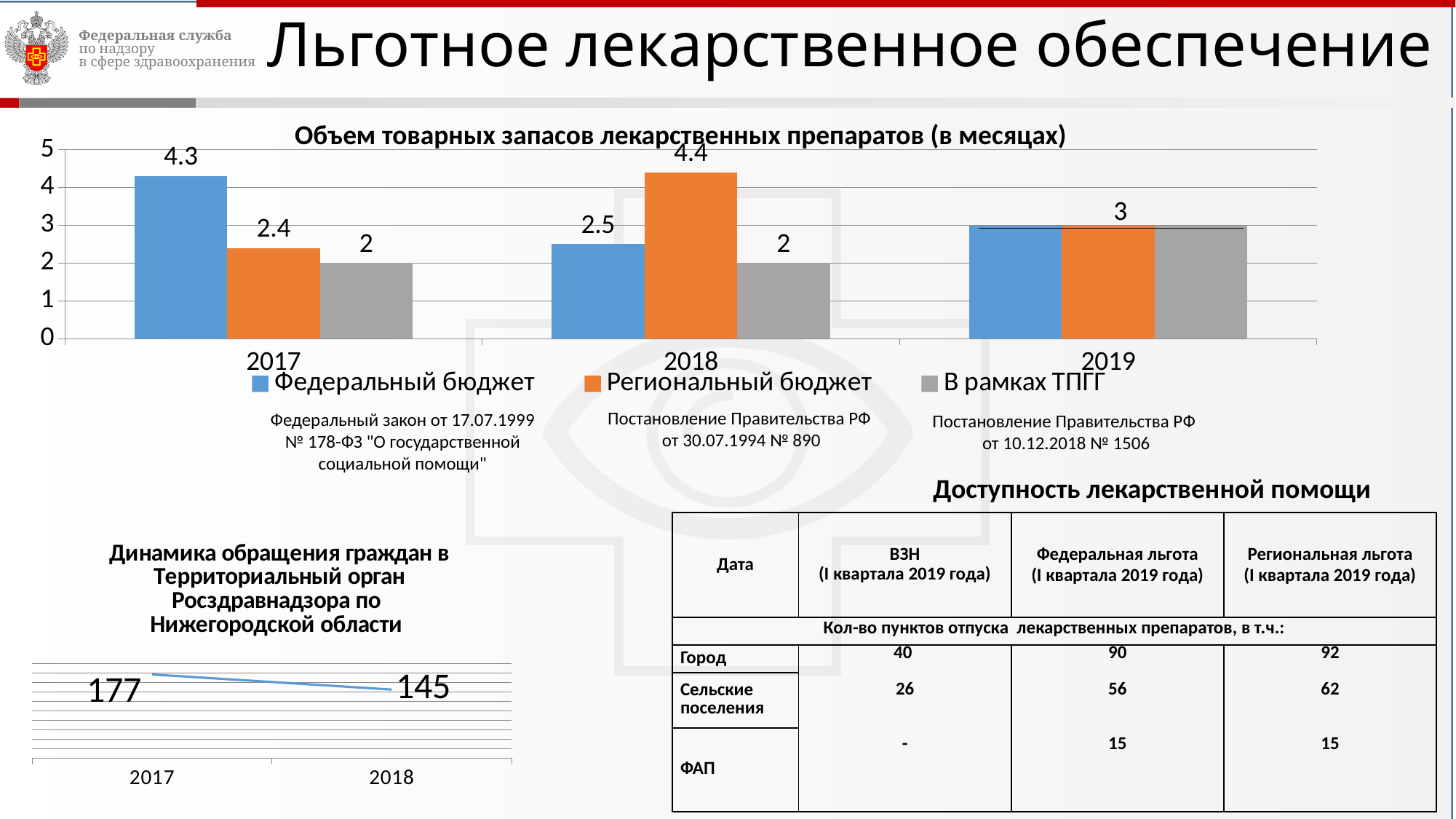
In the chart 'Объем товарных запасов лекарственных препаратов (в месяцах)', what is the value for Региональный бюджет in 2018? 4.4 In the chart 'Динамика обращения граждан в Территориальный орган Росздравнадзора по Нижегородской области', what is the value for 2017? 177 In the chart 'Объем товарных запасов лекарственных препаратов (в месяцах)', which series has the lowest value in 2017? В рамках ТПГГ In the chart 'Объем товарных запасов лекарственных препаратов (в месяцах)', which is larger in 2018: Федеральный бюджет or Региональный бюджет? Региональный бюджет In the chart 'Объем товарных запасов лекарственных препаратов (в месяцах)', what is the difference between Федеральный бюджет and Региональный бюджет in 2017? 1.9 How many years are shown on the x axis of the chart 'Объем товарных запасов лекарственных препаратов (в месяцах)'? 3 In the chart 'Объем товарных запасов лекарственных препаратов (в месяцах)', what is the value for В рамках ТПГГ in 2017? 2 What kind of chart is 'Объем товарных запасов лекарственных препаратов (в месяцах)'? bar chart In the chart 'Объем товарных запасов лекарственных препаратов (в месяцах)', what is the value for Федеральный бюджет in 2017? 4.3 In the chart 'Динамика обращения граждан в Территориальный орган Росздравнадзора по Нижегородской области', do the values rise or fall from 2017 to 2018? fall How many series does the legend of the chart 'Объем товарных запасов лекарственных препаратов (в месяцах)' list? 3 In the chart 'Объем товарных запасов лекарственных препаратов (в месяцах)', which series has the highest value in 2018? Региональный бюджет